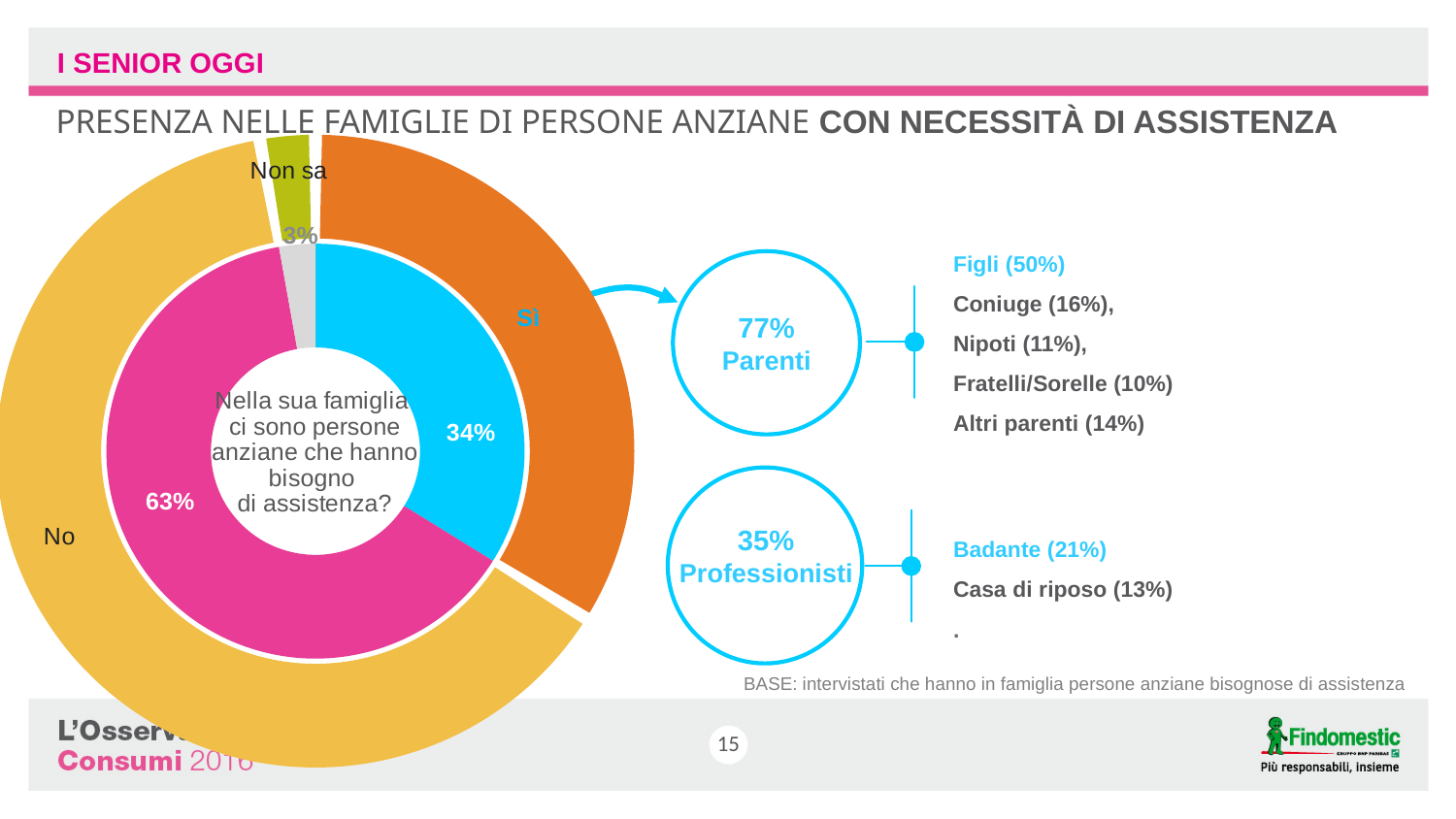
What is the difference in percentage points between "Sì" and "Non sa" in the donut chart? 31 Which is larger in the donut chart, "Sì" or "No"? No What is the value for "Sì" in the donut chart? 34% Which category has the smallest share in the donut chart? Non sa What kind of chart is shown on the slide? pie chart (donut) What is the difference in percentage points between "No" and "Sì" in the donut chart? 29 What is the value for "No" in the donut chart? 63% Which category has the largest share in the donut chart? No How many categories does the donut chart show? 3 What question is written in the centre of the donut chart? Nella sua famiglia ci sono persone anziane che hanno bisogno di assistenza? What is the value for "Non sa" in the donut chart? 3% What colour is the "No" segment in the inner ring of the donut chart? pink/magenta